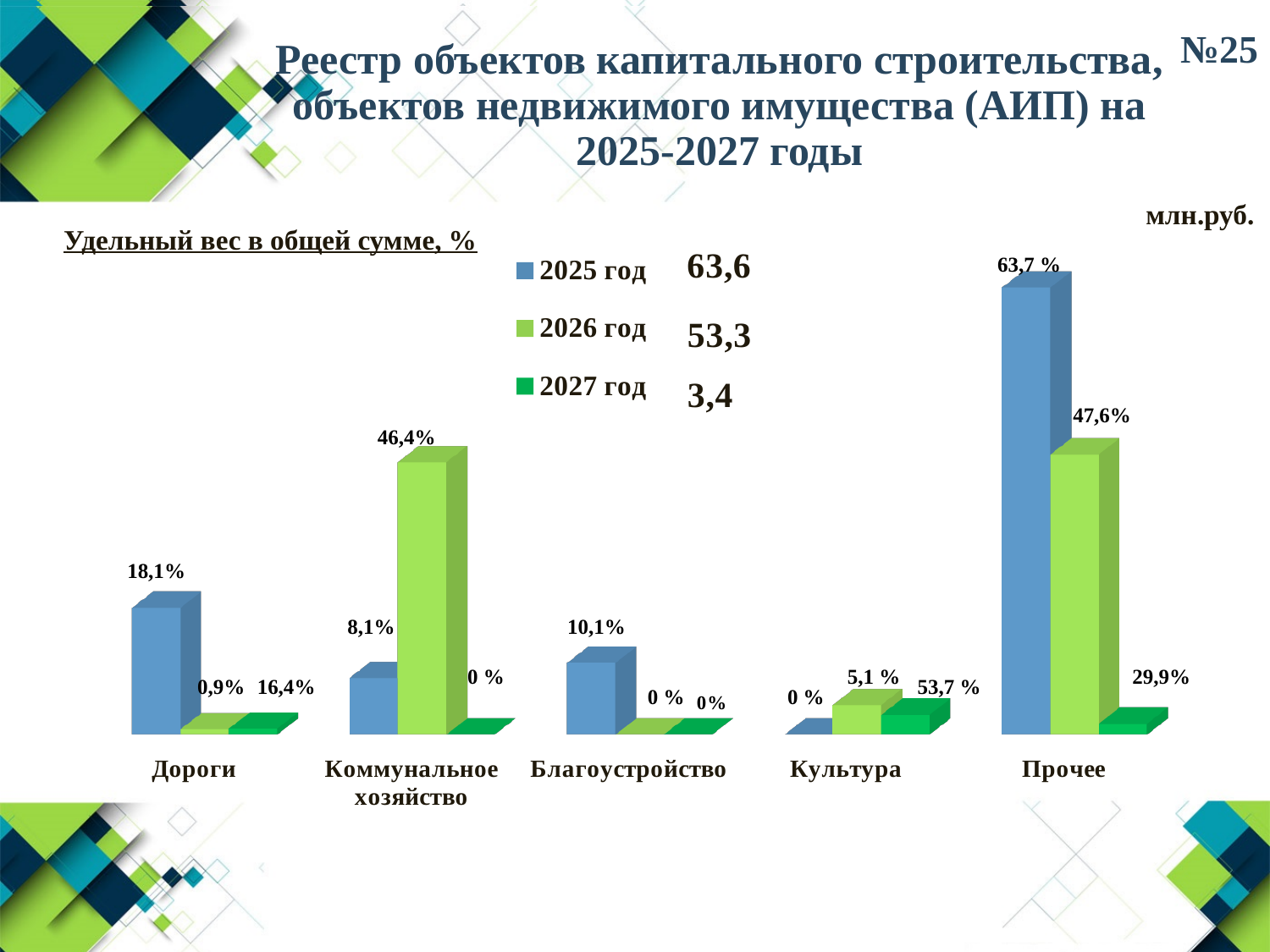
What is the value for Культура in the 2027 год series? 53,7 % What is the value for Прочее in the 2027 год series? 29,9% Which category has the lowest value in the 2025 год series? Культура What is the difference between the 2025 год and 2026 год values for Прочее? 16,1% Which category has the highest value in the 2025 год series? Прочее What kind of chart is shown on the slide? Bar chart How many categories are shown on the x axis of the chart? 5 What is the value for Коммунальное хозяйство in the 2026 год series? 46,4% How many series does the chart legend list? 3 What is the value for Дороги in the 2025 год series? 18,1% What total amount in млн.руб. is shown next to the 2026 год legend entry? 53,3 Which is larger for Дороги: the 2025 год value or the 2027 год value? 2025 год